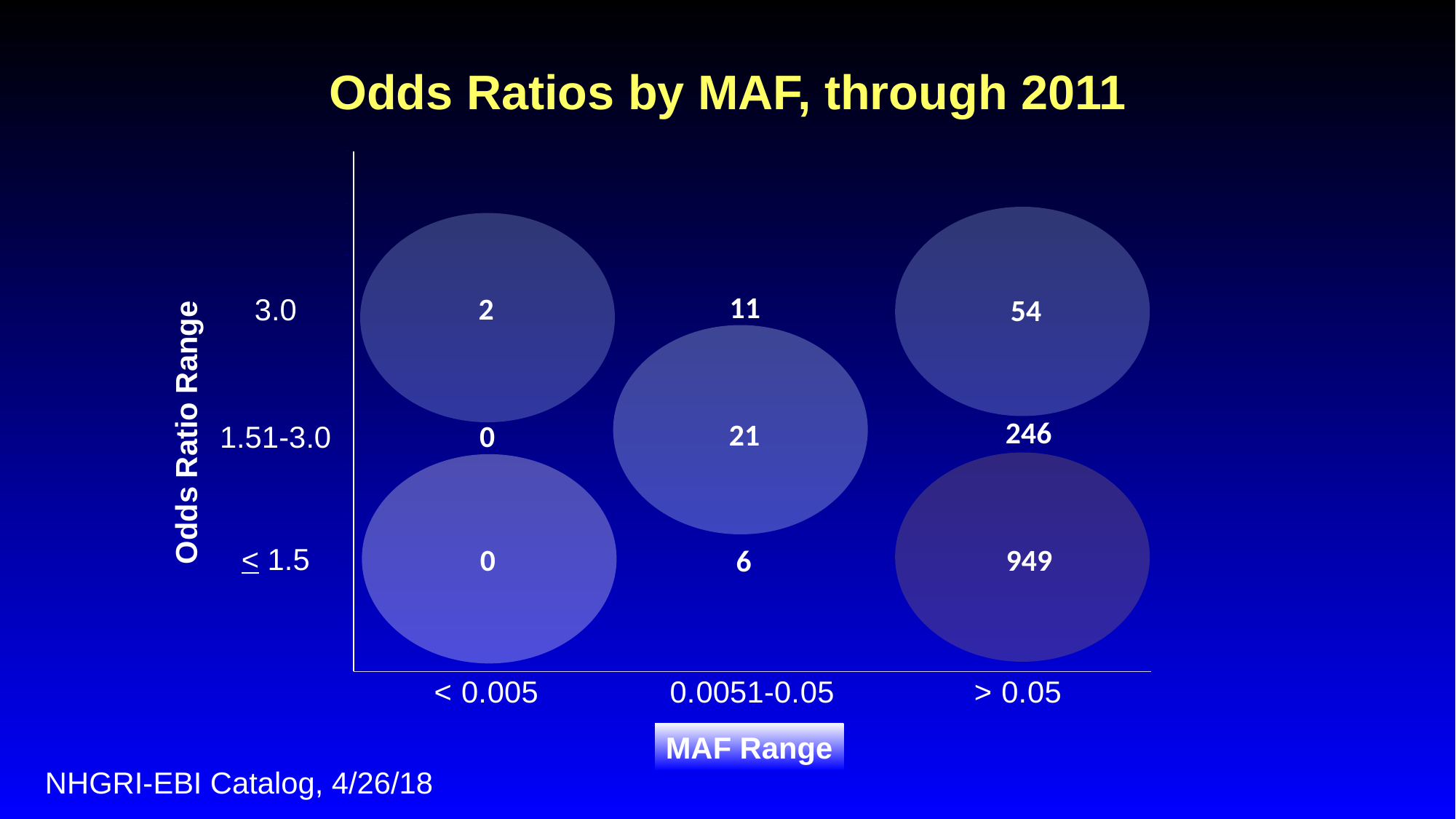
What is the count for MAF range 0.0051-0.05 and odds ratio range 3.0? 11 What is the count for MAF range < 0.005 and odds ratio range 3.0? 2 How many MAF range categories are shown on the x axis? 3 What is the count for MAF range > 0.05 and odds ratio range ≤ 1.5? 949 Which odds ratio range has the lowest count in the > 0.05 MAF column? 3.0 What is the count for MAF range 0.0051-0.05 and odds ratio range 1.51-3.0? 21 Which is larger: the count for 0.0051-0.05 MAF at odds ratio 1.51-3.0, or at odds ratio 3.0? 1.51-3.0 What is the difference between the counts for > 0.05 MAF in the ≤ 1.5 row and the 1.51-3.0 row? 703 Which MAF range has the highest count in the ≤ 1.5 odds ratio row? > 0.05 What is the count for MAF range > 0.05 and odds ratio range 1.51-3.0? 246 What is the title of the chart? Odds Ratios by MAF, through 2011 What is the total count across all three odds ratio ranges for MAF > 0.05? 1249